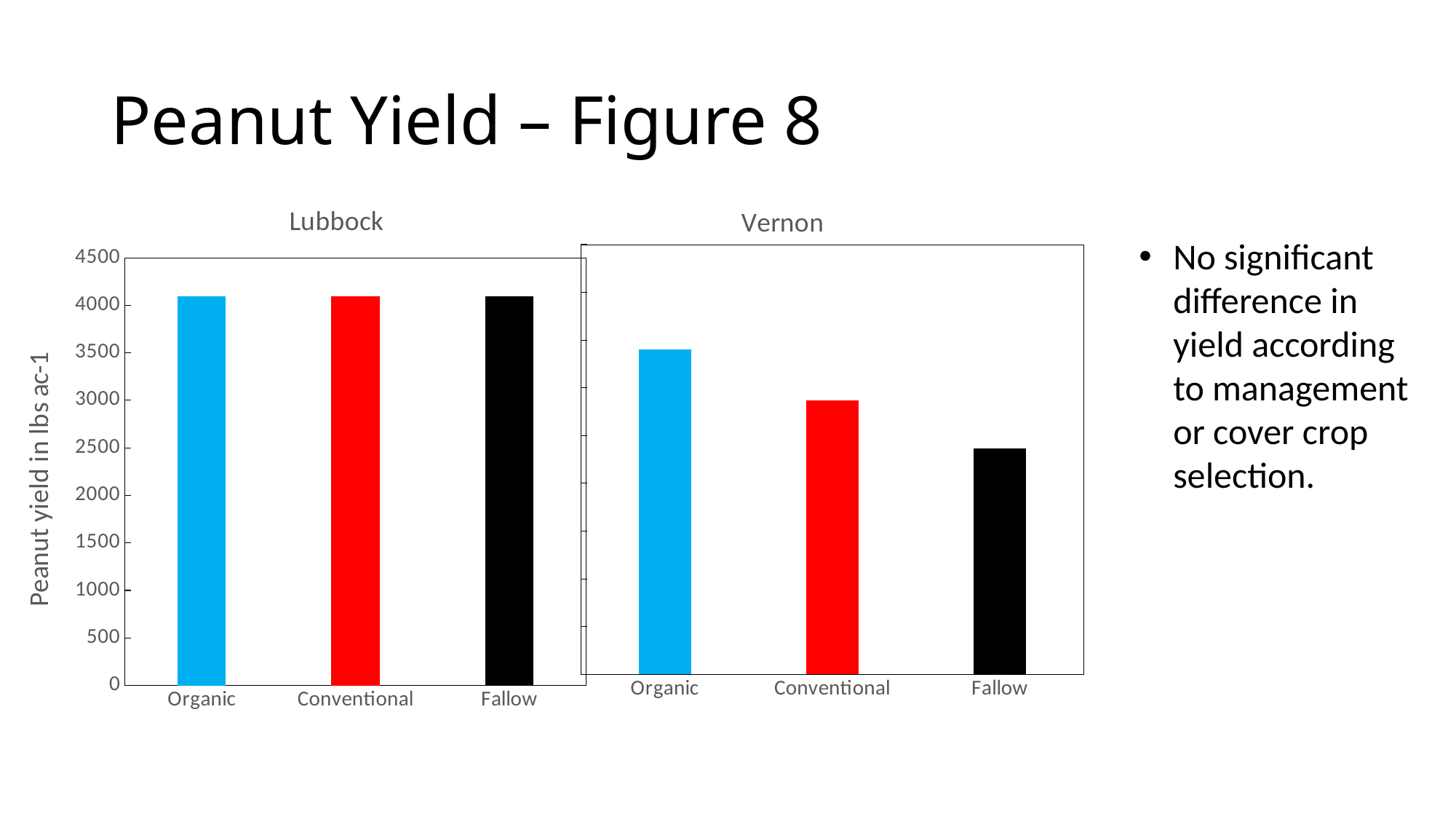
In the Vernon chart, is the yield for Conventional or Fallow larger? Conventional In the Vernon chart, which category has the lowest yield? Fallow In the Vernon chart, do the values rise or fall from Organic to Fallow? fall What colour is the Conventional bar in the Vernon chart? red In the Lubbock chart, is the value for Conventional greater or less than 4000? greater How many categories are shown in the Vernon chart? 3 In the Lubbock chart, is the value for Fallow greater or less than 3500? greater What is the label on the y axis of the Lubbock chart? Peanut yield in lbs ac-1 In the Vernon chart, is the yield for Organic or Conventional larger? Organic In the Vernon chart, which category has the highest yield? Organic What kind of chart is the Lubbock chart? bar chart In the Lubbock chart, is the value for Organic greater or less than 4500? less